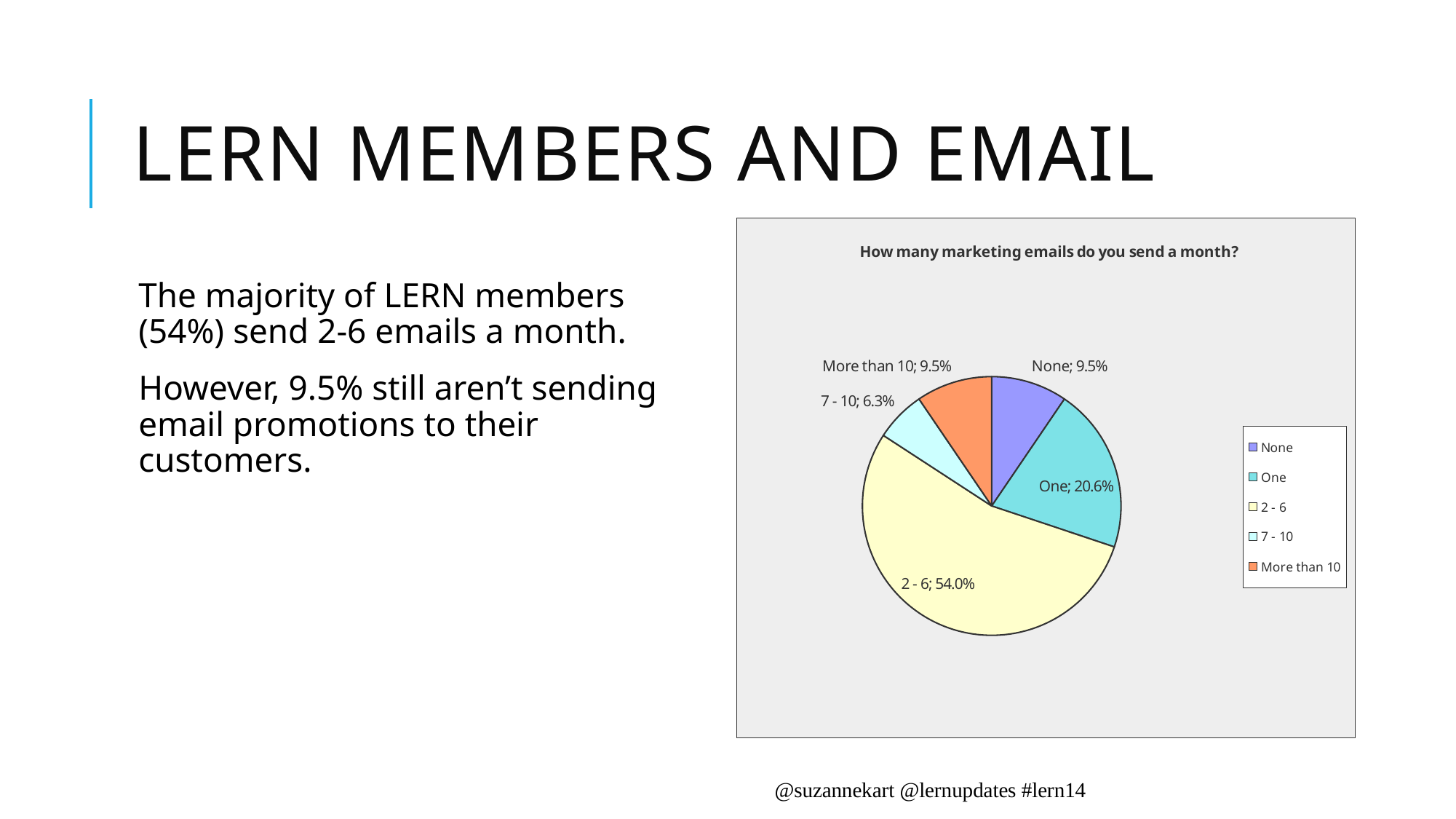
Which is larger, the "One" slice or the "More than 10" slice? One Which category has the smallest slice of the pie? 7 - 10 What is the title of the chart? How many marketing emails do you send a month? How many categories does the pie chart have? 5 What is the value for the "One" slice? 20.6% Which category has the largest slice of the pie? 2 - 6 What kind of chart is shown on the slide? pie chart What is the value for the "7 - 10" slice? 6.3% What share of the pie is the "2 - 6" slice? 54.0% What colour is the "More than 10" slice in the legend? orange What is the difference between the "2 - 6" slice and the "One" slice? 33.4% What is the value for the "None" slice? 9.5%